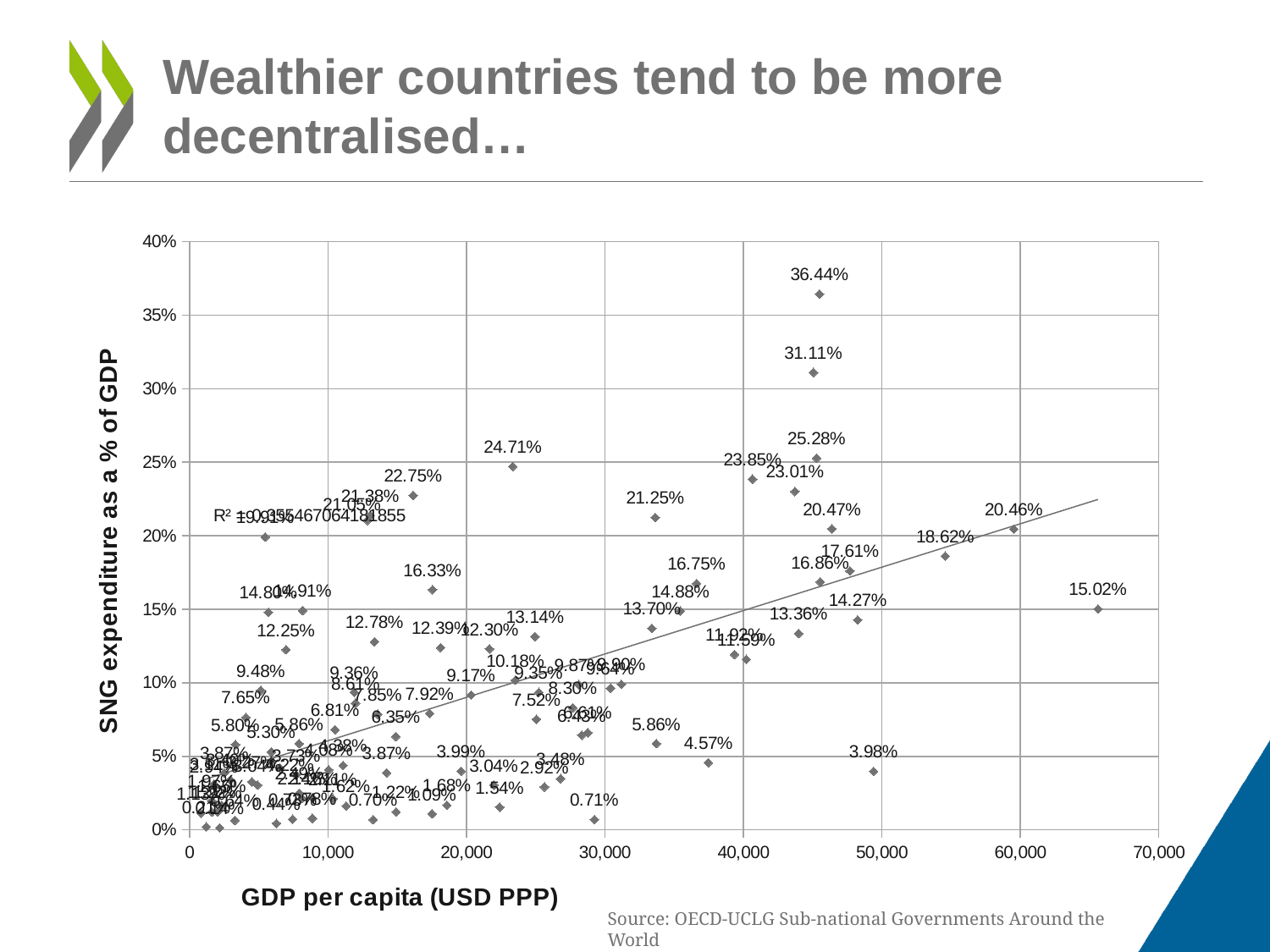
What is the labelled SNG expenditure value of the point with the highest GDP per capita (around 65,000 USD PPP)? 15.02% What is the second-highest SNG expenditure value labelled on the chart? 31.11% What is the title of the x axis? GDP per capita (USD PPP) What is the highest SNG expenditure value labelled on the chart? 36.44% What is the maximum value shown on the y axis? 40% What is the difference between the two highest labelled values, 36.44% and 31.11%? 5.33% Does the fitted trend line rise or fall as GDP per capita increases? rises Which is larger, the labelled value 24.71% or the labelled value 22.75%? 24.71% Is the highest point on the chart greater or less than 35% on the y axis? greater What kind of chart is shown on the slide? scatter chart